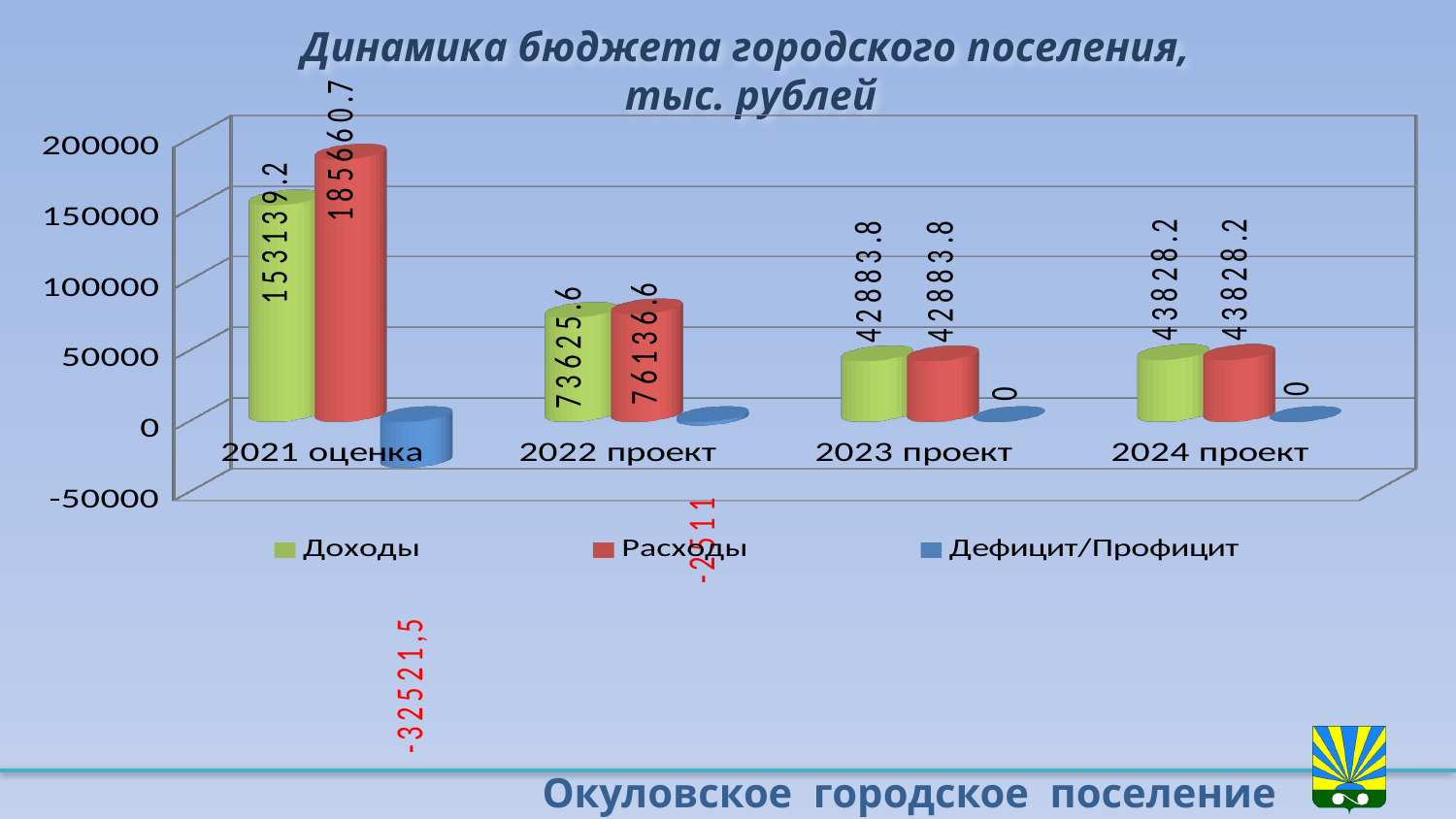
Which is larger for 2022 проект, Доходы or Расходы? Расходы How many categories are shown on the x axis? 4 What is the value of Дефицит/Профицит for 2021 оценка? -32521,5 What is the value of Расходы for 2021 оценка? 185660.7 Which category has the lowest value of Доходы? 2023 проект Which category has the highest value of Расходы? 2021 оценка What is the difference between Расходы and Доходы for 2021 оценка? 32521.5 What kind of chart is shown on the slide? bar chart What is the value of Дефицит/Профицит for 2023 проект? 0 How many series does the legend list? 3 What is the value of Расходы for 2022 проект? 76136.6 What is the value of Доходы for 2021 оценка? 153139.2